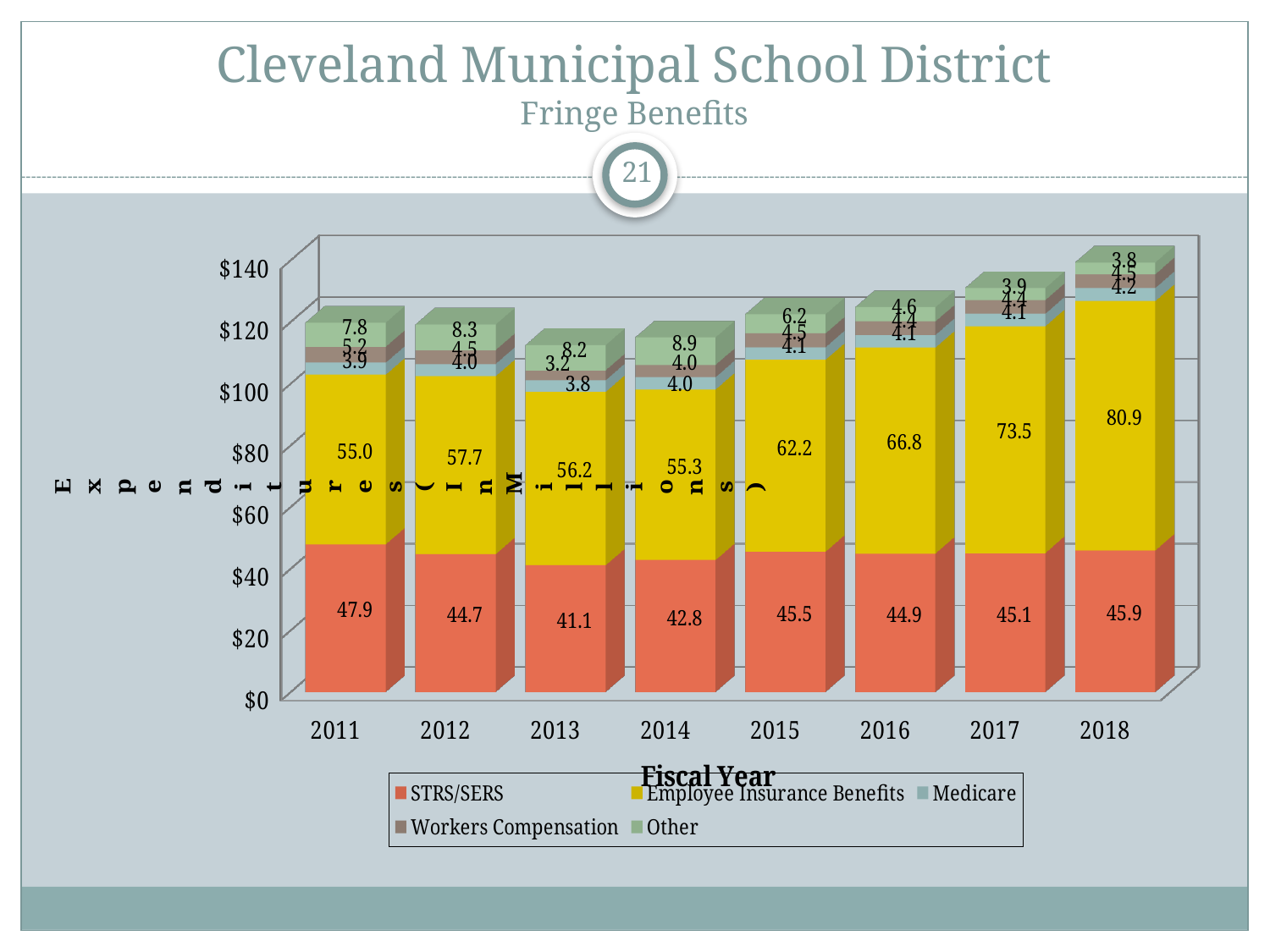
What is the title of the x axis? Fiscal Year How many fiscal years are shown on the x axis? 8 Is the total of the 2013 stacked bar greater or less than $120? less What is the STRS/SERS value for 2013? 41.1 How many series does the legend list? 5 In which fiscal year is the STRS/SERS value lowest? 2013 What is the difference between the Employee Insurance Benefits values for 2018 and 2011? 25.9 In which fiscal year is the Employee Insurance Benefits value highest? 2018 What kind of chart is shown on the slide? Stacked bar chart What is the Employee Insurance Benefits value for 2018? 80.9 What is the Other value for 2014? 8.9 Which year has the larger STRS/SERS value, 2011 or 2018? 2011